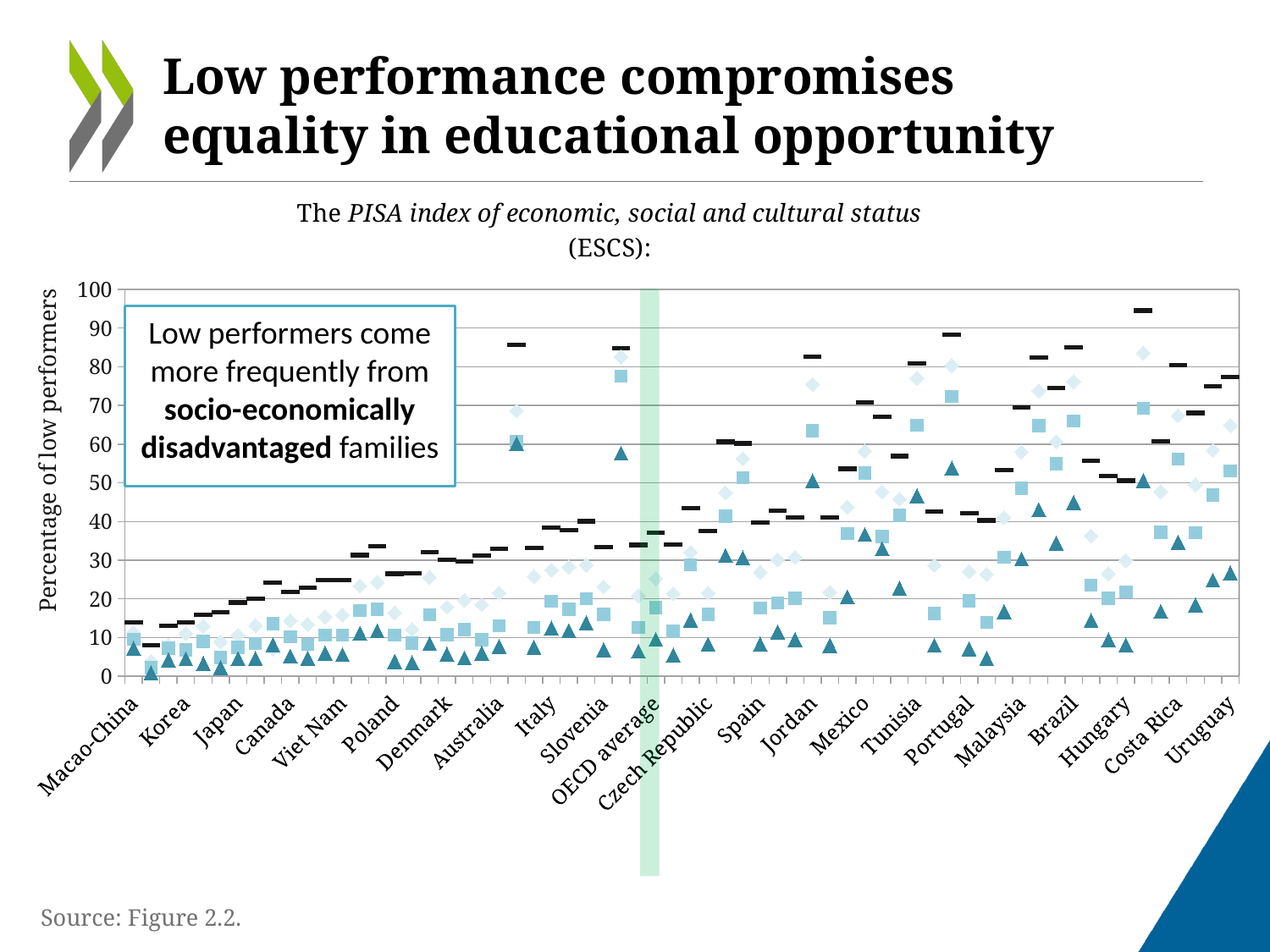
Which category on the x axis is highlighted with a green vertical band? OECD average What is the first category on the x axis of the chart? Macao-China Do the black dash markers generally rise or fall from left to right along the x axis? rise Is the highest marker (black dash) for Hungary greater or less than 90? less Which has the higher black dash marker, Uruguay or Macao-China? Uruguay Is the highest marker (black dash) for Korea greater or less than 20? less What is the y-axis label of the chart? Percentage of low performers Is the highest marker (black dash) for the OECD average greater or less than 30? greater Which has the higher black dash marker, Hungary or Canada? Hungary